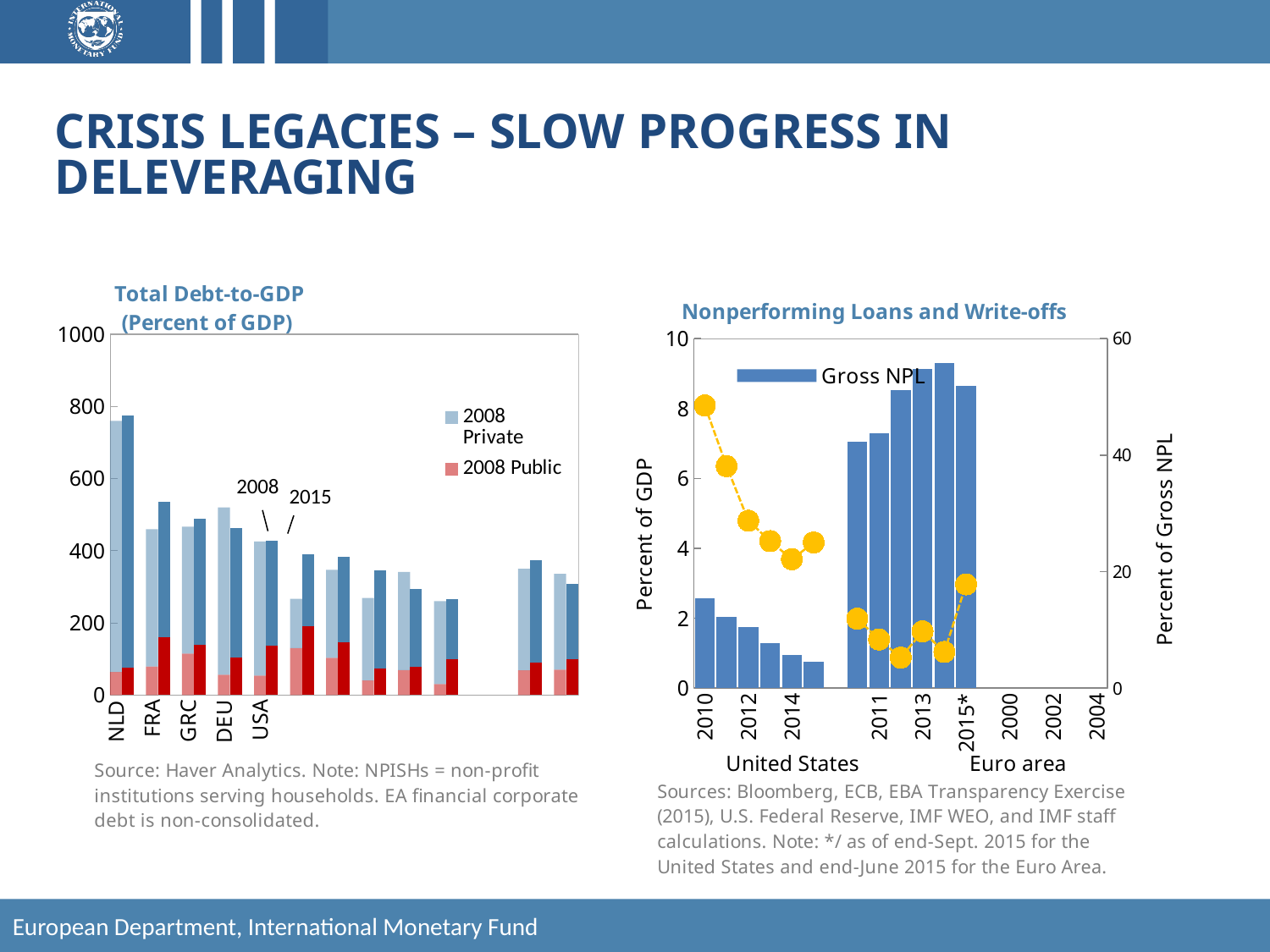
In the 'Nonperforming Loans and Write-offs' chart, what series does the legend list? Gross NPL In the 'Total Debt-to-GDP' chart, is the 2015 total for USA greater or less than 600? less What kind of chart is the 'Total Debt-to-GDP' chart on the left? bar chart In the 'Total Debt-to-GDP' chart, which is larger for 2008: NLD or FRA? NLD In the 'Total Debt-to-GDP' chart, how many series does the legend list? 2 In the 'Nonperforming Loans and Write-offs' chart, which region has the higher Gross NPL bars: United States or Euro area? Euro area In the 'Total Debt-to-GDP' chart, which of the labeled countries has the highest total debt-to-GDP? NLD In the 'Total Debt-to-GDP' chart, is the 2008 total for NLD greater or less than 600? greater In the 'Nonperforming Loans and Write-offs' chart, is the Euro area Gross NPL bar for 2013 greater or less than 8 percent of GDP? greater In the 'Nonperforming Loans and Write-offs' chart, what is the label of the left vertical axis? Percent of GDP In the 'Total Debt-to-GDP' chart, which is larger for DEU: the 2008 bar or the 2015 bar? 2008 In the 'Nonperforming Loans and Write-offs' chart, do the United States Gross NPL bars rise or fall from 2010 onward? fall